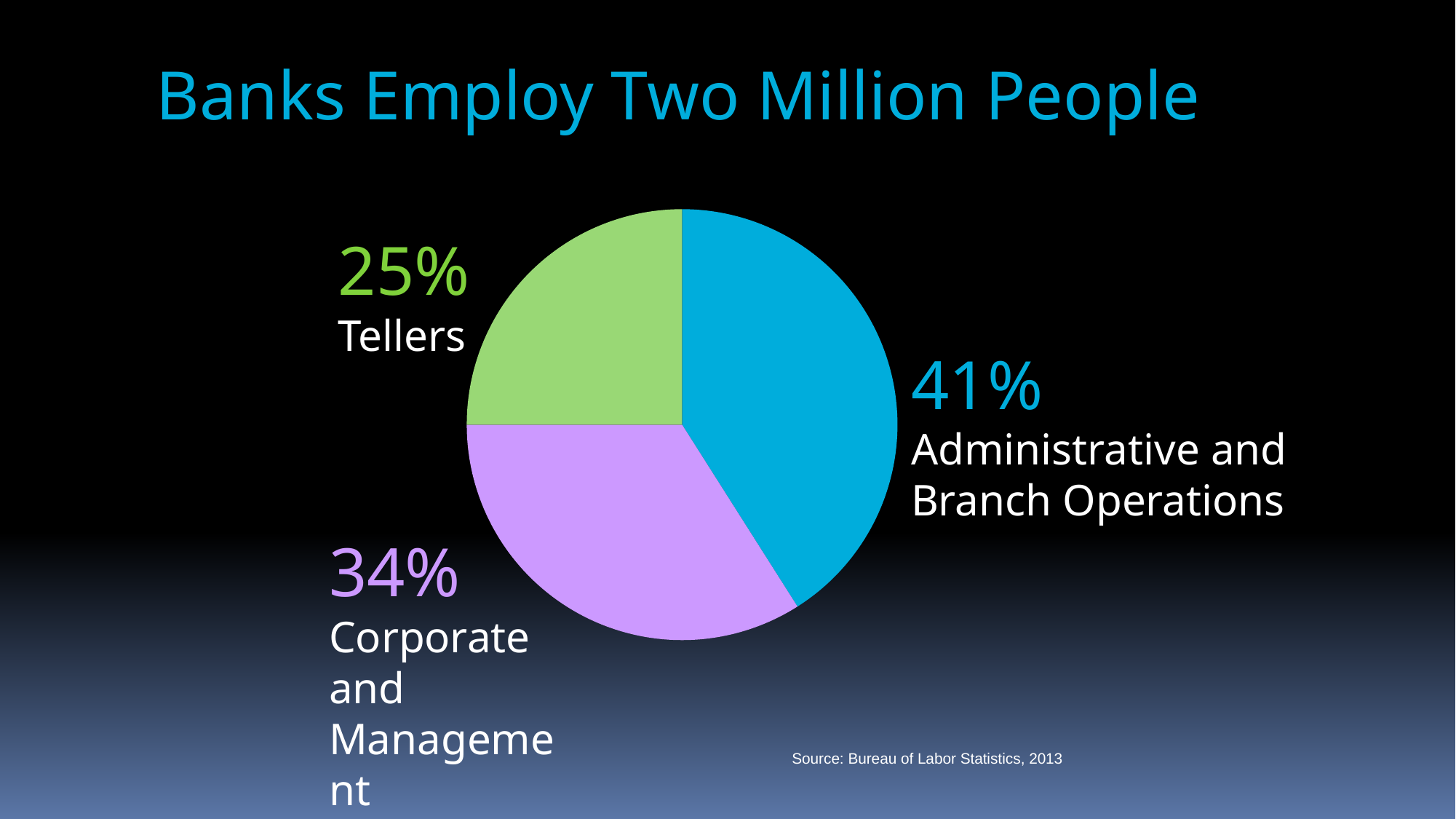
What is the difference in percentage points between Administrative and Branch Operations and Tellers? 16 How many slices does the pie chart have? 3 What is the difference in percentage points between Corporate and Management and Tellers? 9 What share of bank employees work in Corporate and Management? 34% Which category has the largest share of the pie? Administrative and Branch Operations What is the title of the slide containing the pie chart? Banks Employ Two Million People Which is larger, the share for Corporate and Management or the share for Tellers? Corporate and Management What share of bank employees are Tellers? 25% What share of bank employees work in Administrative and Branch Operations? 41% What colour is the Tellers slice of the pie chart? green Which category has the smallest share of the pie? Tellers What kind of chart is shown on the slide? pie chart